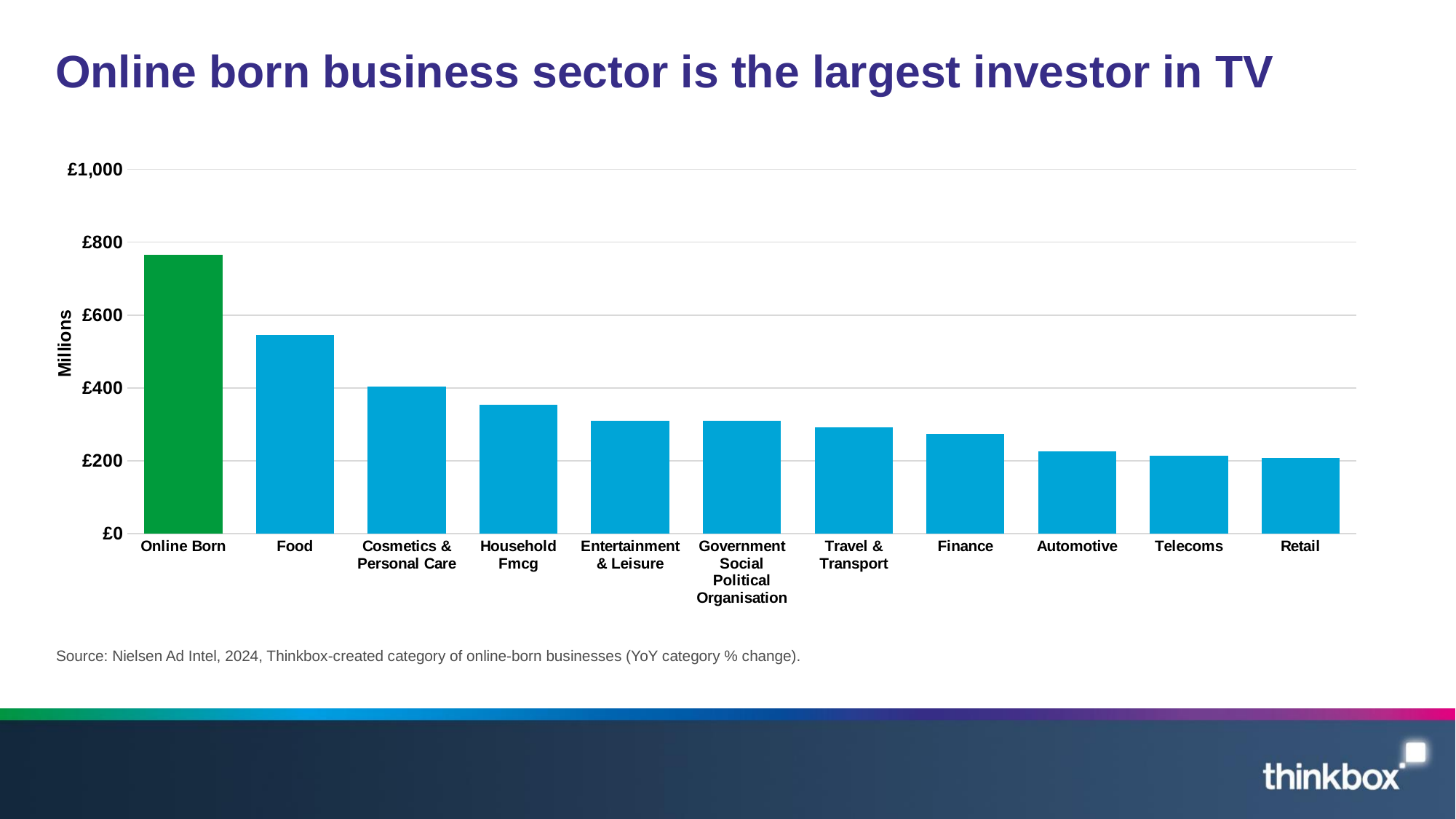
Which sector has the highest TV investment in the chart? Online Born How many sectors are shown on the x axis of the chart? 11 Is the value for Household Fmcg greater or less than £400? less What kind of chart is shown on the slide? bar chart Do the bar values rise or fall moving from left to right along the x axis? fall Is the value for Finance greater or less than £400? less Is the value for Food greater or less than £400? greater Which is larger, the value for Online Born or the value for Food? Online Born What colour is the Online Born bar? green Which is larger, the value for Food or the value for Cosmetics & Personal Care? Food